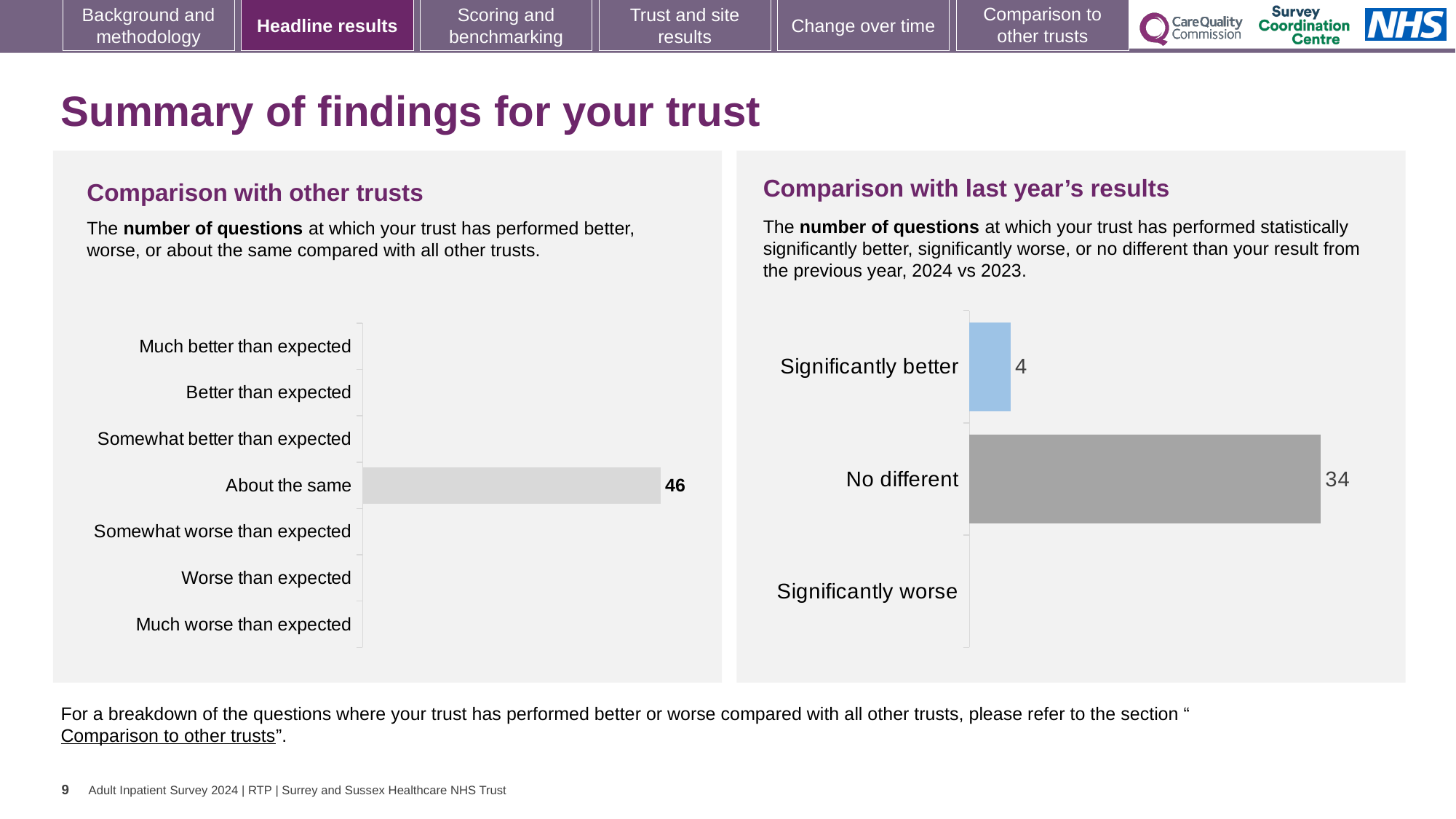
What kind of chart is the 'Comparison with other trusts' chart? Bar chart How many categories are shown in the 'Comparison with last year's results' chart? 3 In the 'Comparison with other trusts' chart, which category has the highest value? About the same In the 'Comparison with last year's results' chart, what is the difference between 'No different' and 'Significantly better'? 30 In the 'Comparison with last year's results' chart, what colour is the 'Significantly better' bar? Light blue In the 'Comparison with last year's results' chart, what is the value for 'Significantly better'? 4 In the 'Comparison with other trusts' chart, what is the value for 'About the same'? 46 What kind of chart is the 'Comparison with last year's results' chart? Bar chart How many categories are shown in the 'Comparison with other trusts' chart? 7 In the 'Comparison with last year's results' chart, which category has the highest value? No different In the 'Comparison with last year's results' chart, what is the value for 'No different'? 34 In the 'Comparison with last year's results' chart, which is larger: 'Significantly better' or 'No different'? No different